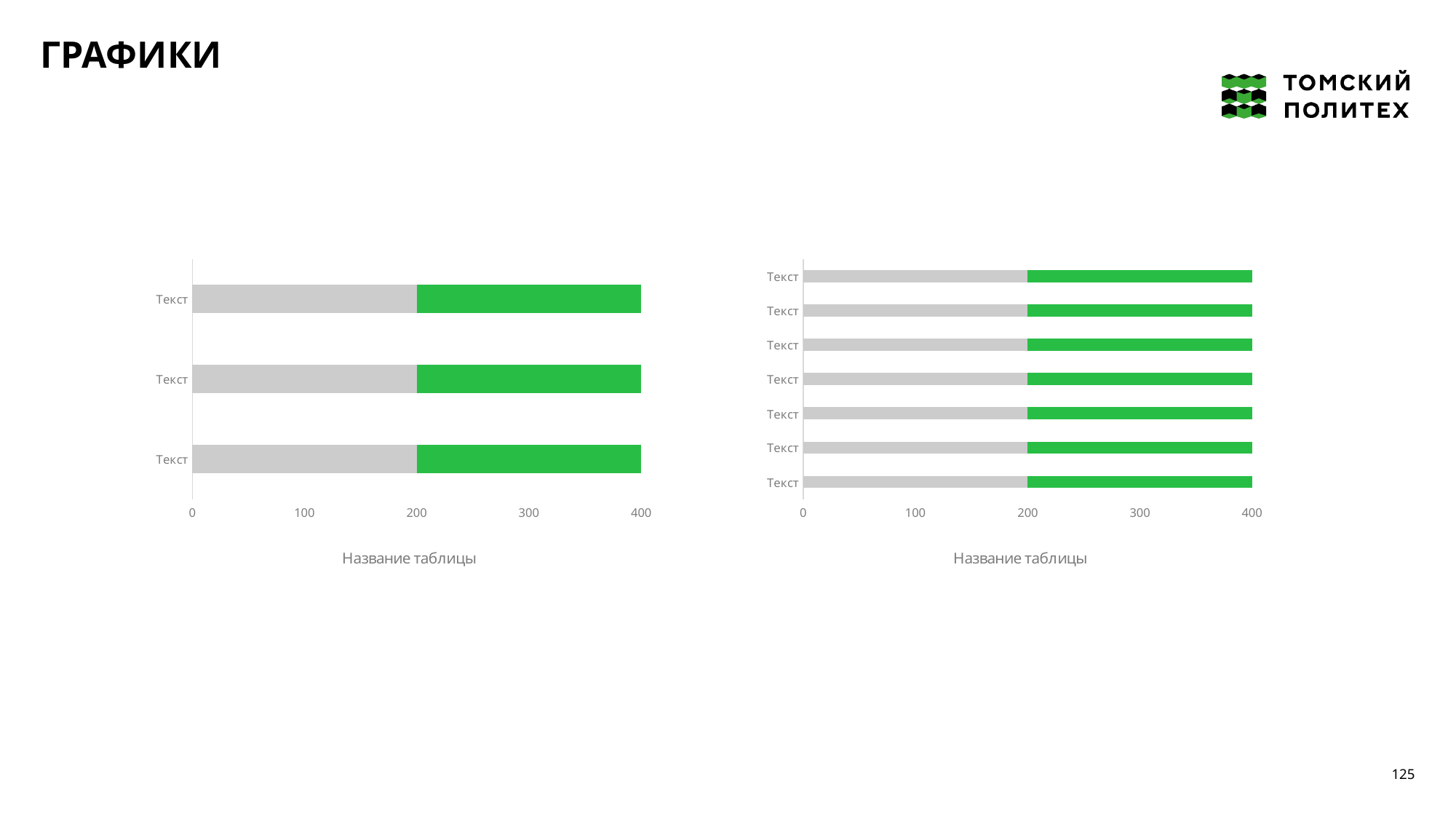
In the chart on the right of the slide, what is the total length of the bottom stacked bar? 400 In the chart on the right of the slide, at what value does the green segment of the top bar end? 400 What kind of chart is the chart on the left of the slide? bar chart What is the title shown below the chart on the left of the slide? Название таблицы In the chart on the left of the slide, what is the total length of the top stacked bar? 400 What kind of chart is the chart on the right of the slide? bar chart What is the highest value shown on the horizontal axis of the chart on the right of the slide? 400 In the chart on the left of the slide, at what value does the grey segment of the top bar end? 200 In the chart on the right of the slide, is the grey segment of the top bar greater or less than 300? less How many bars does the chart on the right of the slide have? 7 In the chart on the left of the slide, is the total of the bottom bar greater or less than 300? greater How many bars does the chart on the left of the slide have? 3